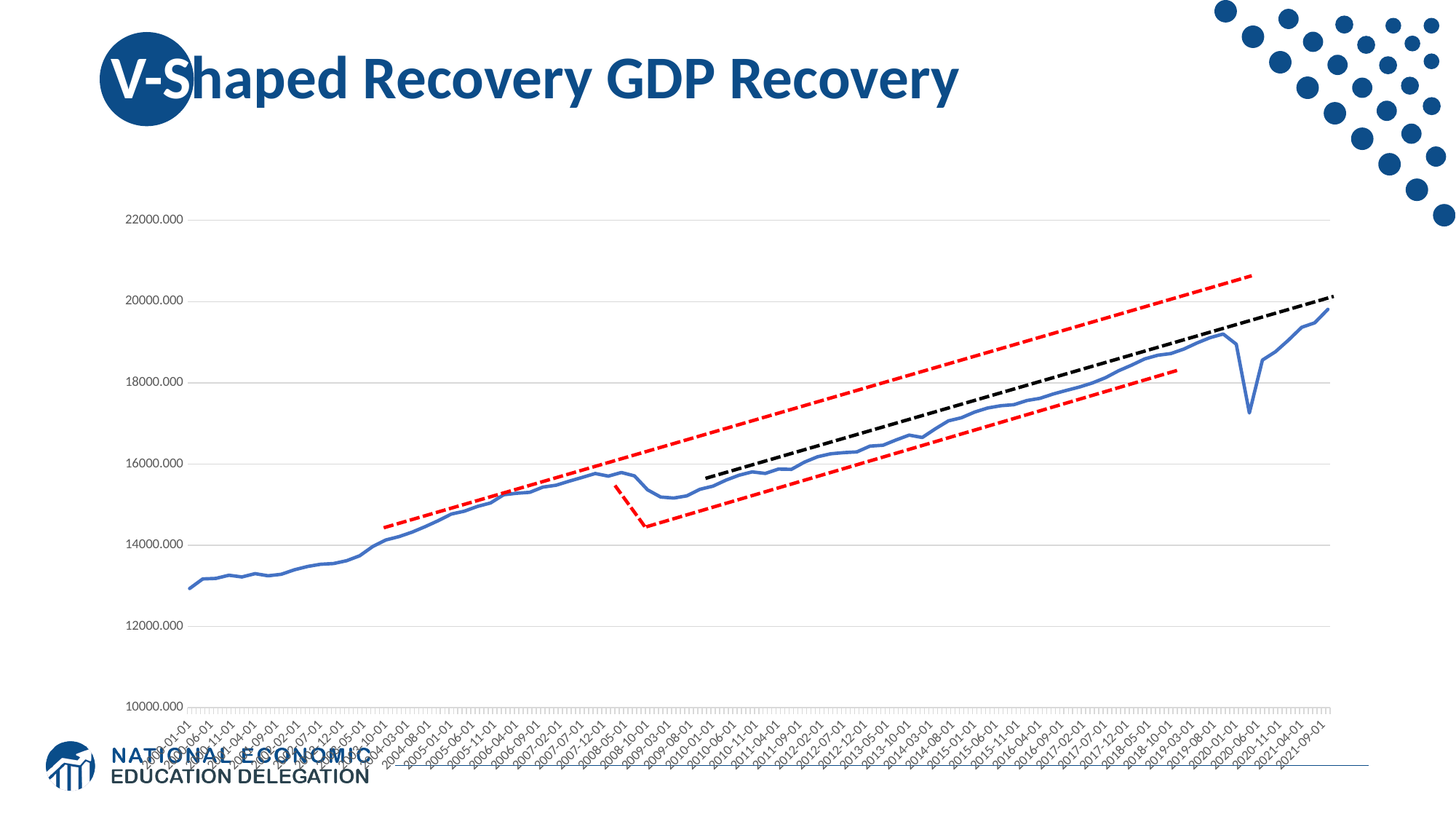
Is the value at 2009-03-01 greater or less than 16000.000? less What kind of chart is shown on the slide? line chart Overall, do the plotted values rise or fall from 2001-01-01 to 2021-09-01? rise Is the value at 2021-09-01 greater or less than 18000.000? greater Is the value at 2001-01-01 greater or less than 14000.000? less Which is larger, the value at 2019-08-01 or the value at 2020-06-01? 2019-08-01 At which x-axis date does the plotted line reach its highest value? 2021-09-01 What is the title of the slide containing the chart? V-Shaped Recovery GDP Recovery What is the highest value labelled on the vertical axis? 22000.000